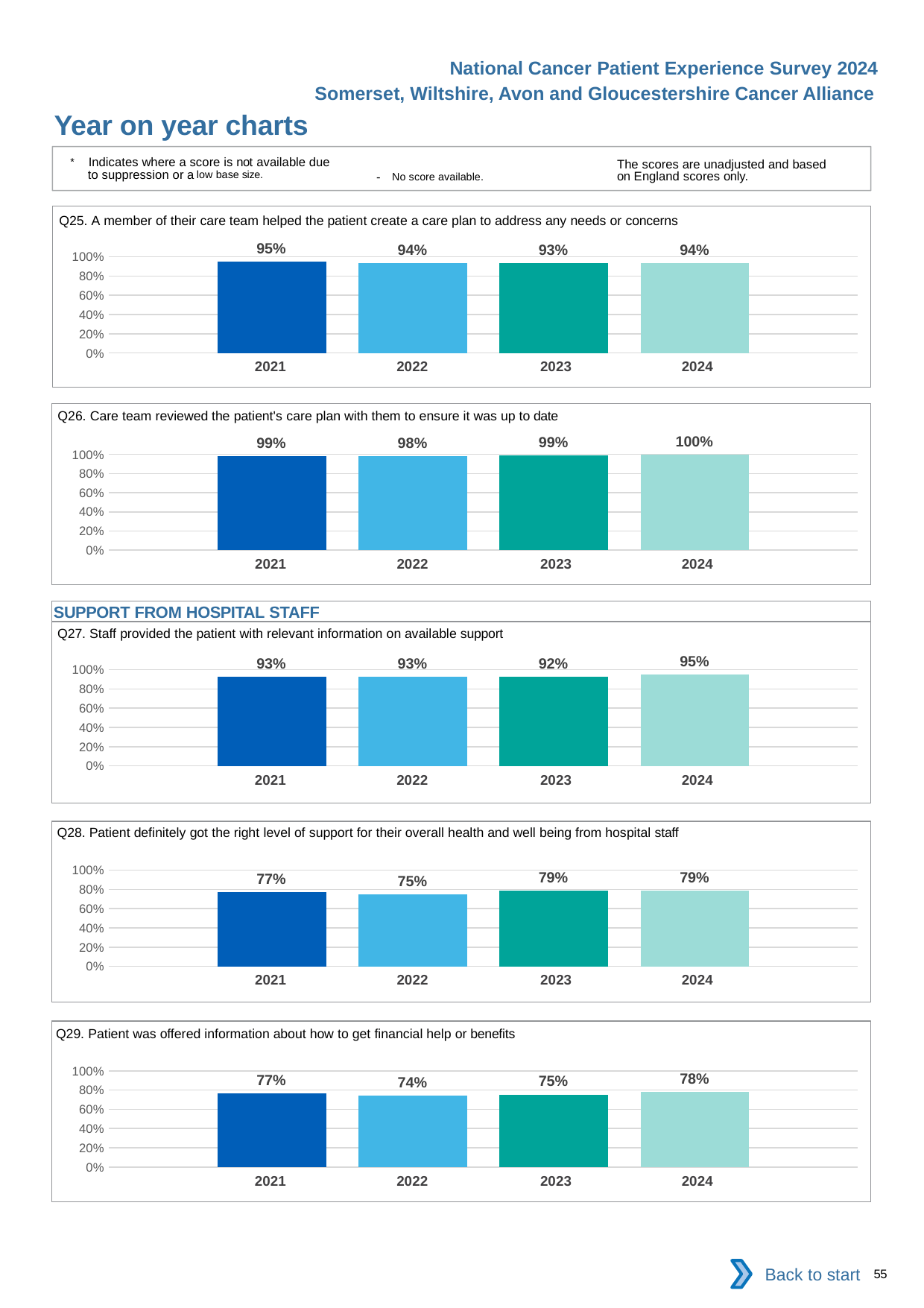
In the Q28 chart, which is larger, the value for 2021 or the value for 2022? 2021 In the Q26 chart, which year has the highest value? 2024 In the Q28 chart, what is the value for 2022? 75% In the Q29 chart, what is the difference between the 2024 value and the 2022 value? 4% In the Q25 chart, what is the value for 2021? 95% What type of chart is used for Q28? Bar chart How many years are shown in the Q25 chart? 4 In the Q26 chart, which year has the lowest value? 2022 In the Q27 chart, what is the difference between the 2024 value and the 2023 value? 3% In the Q29 chart, which year has the lowest value? 2022 In the Q27 chart, what is the value for 2024? 95% In the Q29 chart, is the value for 2023 greater or less than 80%? less